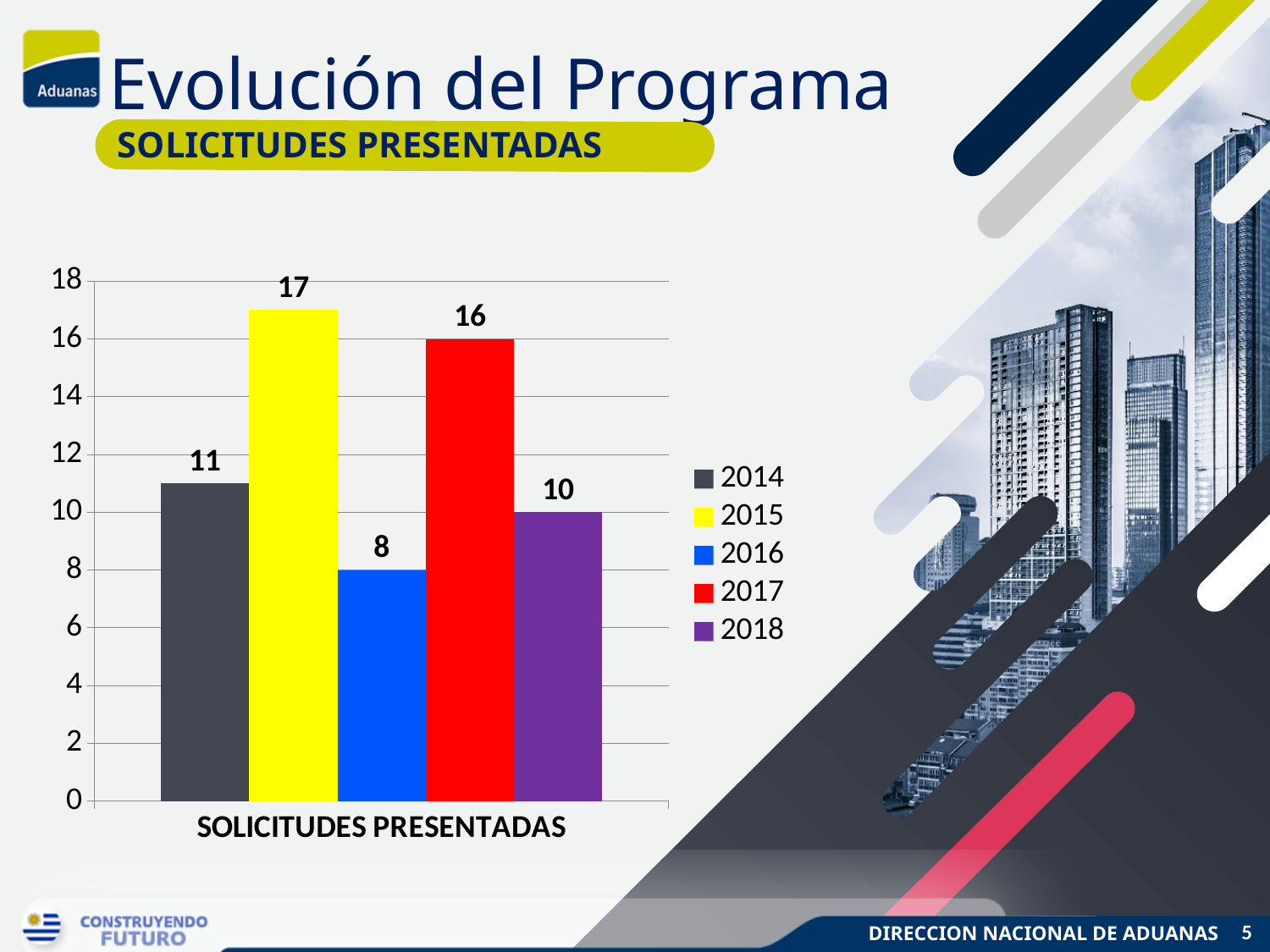
What is the difference between the values for 2017 and 2014? 5 What is the value for 2018 in the SOLICITUDES PRESENTADAS chart? 10 What is the difference between the values for 2015 and 2016? 9 Which year has the highest value in the SOLICITUDES PRESENTADAS chart? 2015 What colour is the bar for 2017? red How many series does the legend list? 5 Is the value for 2017 greater or less than 14? greater What kind of chart is shown on the slide? bar chart What is the value for 2015 in the SOLICITUDES PRESENTADAS chart? 17 Which is larger, the value for 2014 or the value for 2018? 2014 Which year has the lowest value in the SOLICITUDES PRESENTADAS chart? 2016 What is the value for 2016 in the SOLICITUDES PRESENTADAS chart? 8